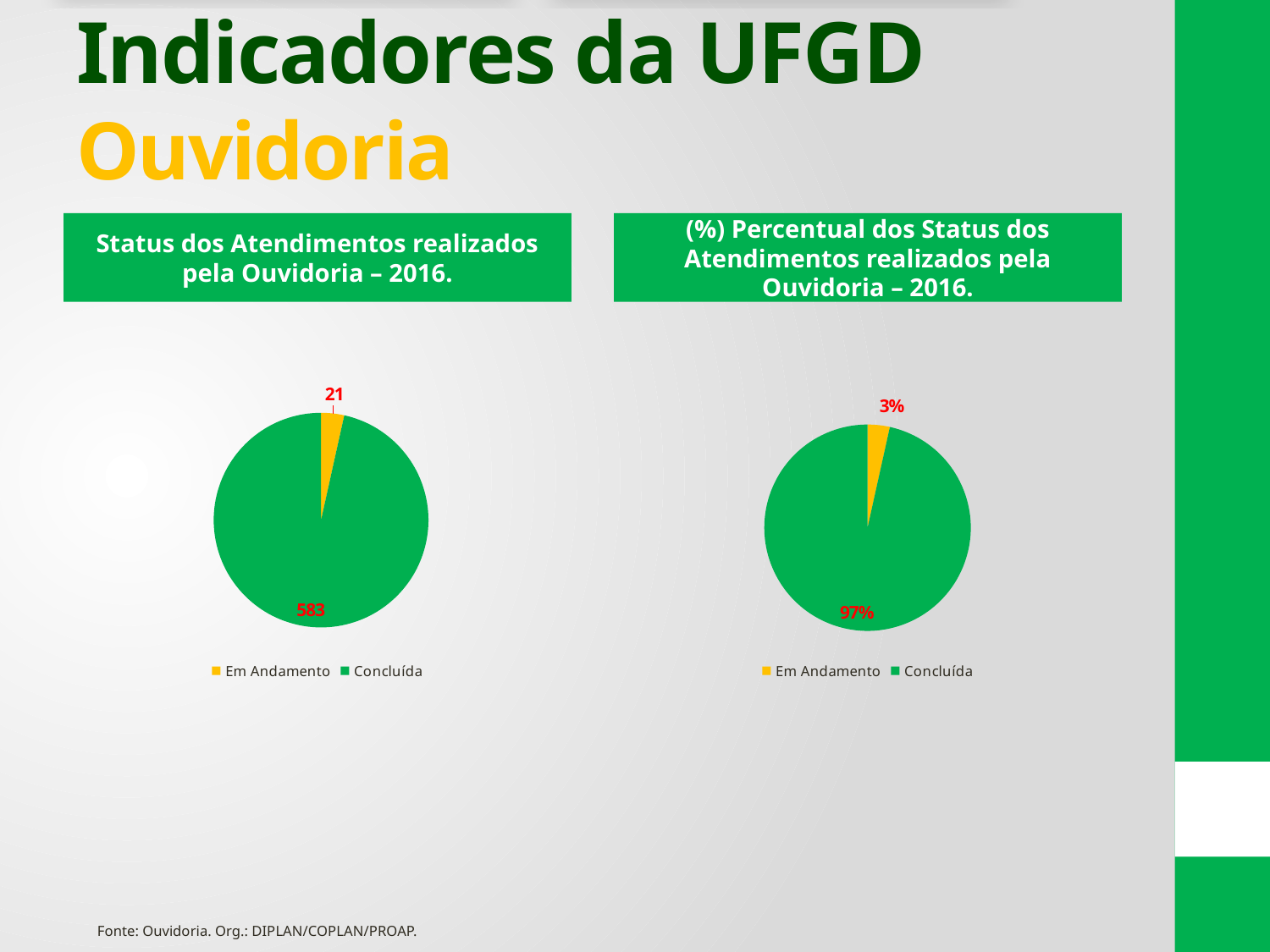
How many categories does the legend of the left chart (Status dos Atendimentos realizados pela Ouvidoria – 2016) list? 2 In the right chart ((%) Percentual dos Status dos Atendimentos), what colour is the Em Andamento slice? Yellow In the right chart ((%) Percentual dos Status dos Atendimentos), what percentage is shown for Concluída? 97% In the left chart (Status dos Atendimentos realizados pela Ouvidoria – 2016), what is the difference between the Concluída and Em Andamento values? 562 In the right chart ((%) Percentual dos Status dos Atendimentos), which category has the smallest slice? Em Andamento What type of chart is the right chart ((%) Percentual dos Status dos Atendimentos)? Pie chart In the left chart (Status dos Atendimentos realizados pela Ouvidoria – 2016), what is the total of the two slices? 604 In the right chart ((%) Percentual dos Status dos Atendimentos), what percentage is shown for Em Andamento? 3% In the left chart (Status dos Atendimentos realizados pela Ouvidoria – 2016), what is the value for Em Andamento? 21 In the left chart (Status dos Atendimentos realizados pela Ouvidoria – 2016), which category has the largest slice? Concluída In the left chart (Status dos Atendimentos realizados pela Ouvidoria – 2016), which is larger: Em Andamento or Concluída? Concluída In the left chart (Status dos Atendimentos realizados pela Ouvidoria – 2016), what is the value for Concluída? 583